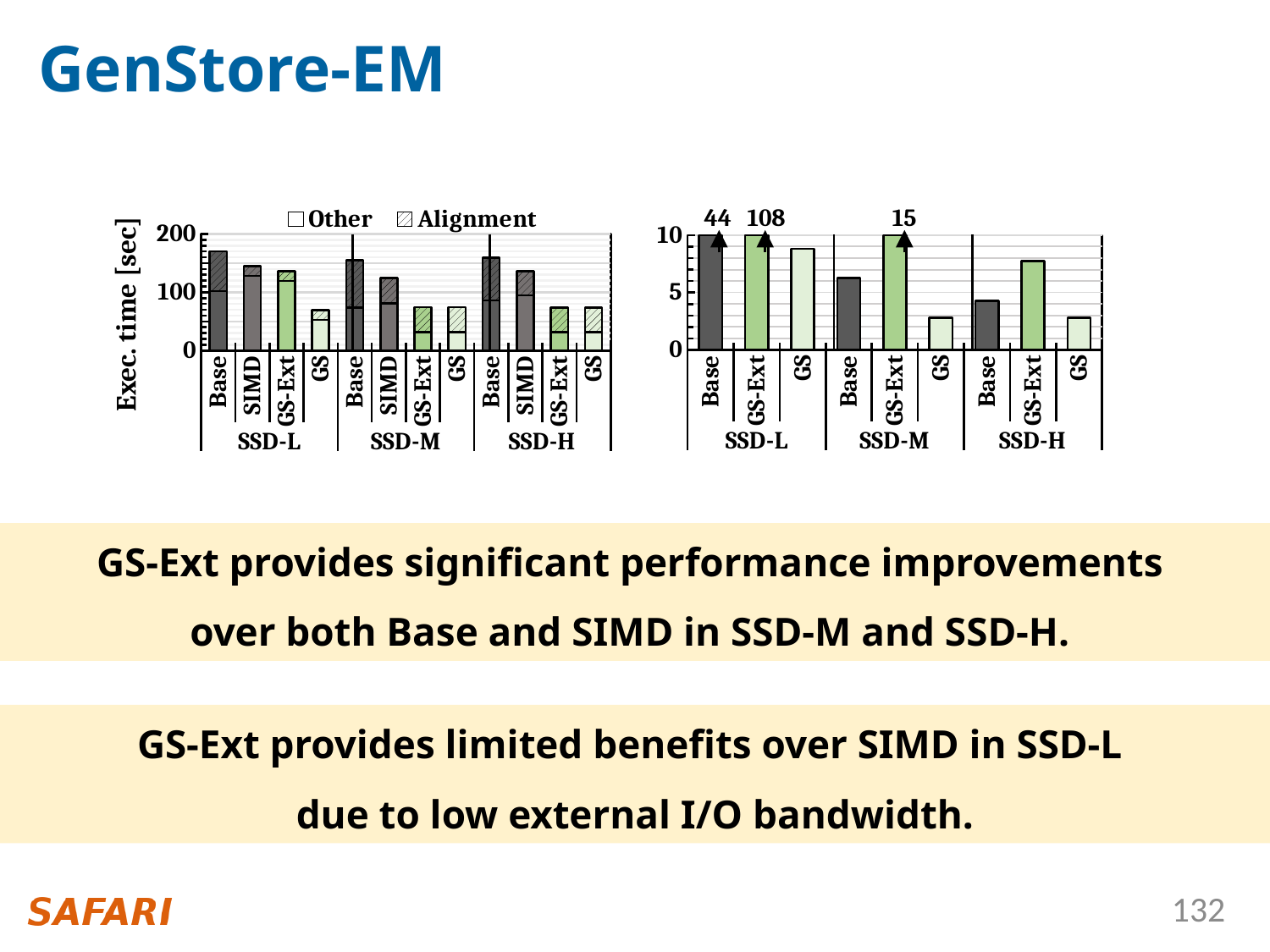
In the left chart, what are the two legend entries? Other, Alignment In the left chart, what is the y-axis label? Exec. time [sec] In the left chart, is the value for GS in SSD-L greater or less than 100? less What kind of chart is the left chart? Bar chart In the left chart, how many series does the legend list? 2 In the left chart, is the value for Base in SSD-L greater or less than 100? greater In the right chart, what value is labelled on the Base bar in SSD-L? 44 In the right chart, is the value for GS in SSD-M greater or less than 5? less In the right chart, what value is labelled on the GS-Ext bar in SSD-L? 108 In the right chart, what value is labelled on the GS-Ext bar in SSD-M? 15 In the right chart, what is the difference between the GS-Ext and Base values in SSD-L? 64